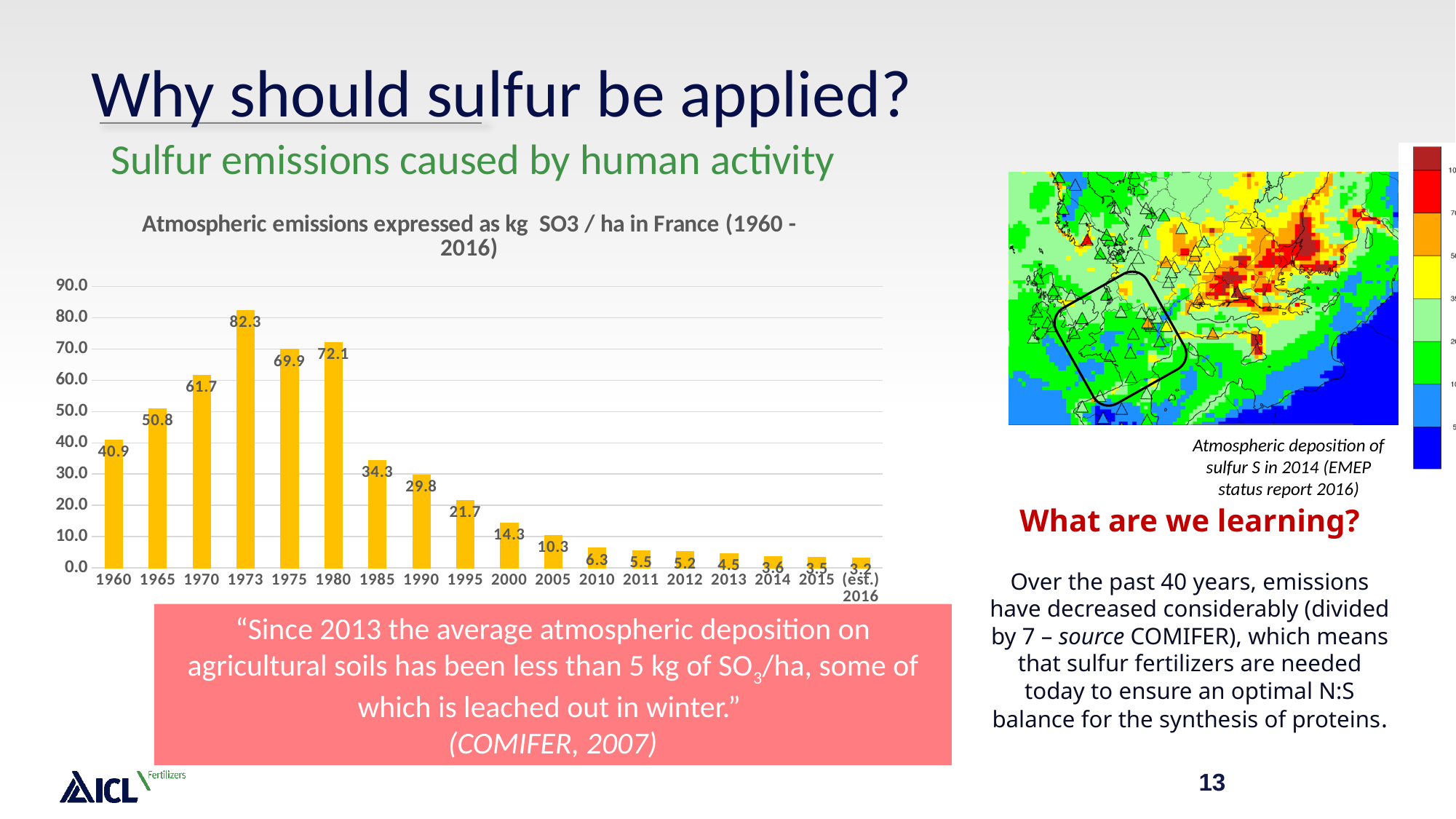
What is the value for 1973 in the chart? 82.3 What kind of chart is shown on the slide? bar chart What is the value for 1960 in the chart? 40.9 Which category has the lowest value in the chart? (est.) 2016 What is the value for 2000 in the chart? 14.3 Which year has the highest value in the chart? 1973 Is the value for 1970 greater or less than 60.0? greater What is the title of the chart? Atmospheric emissions expressed as kg SO3 / ha in France (1960 - 2016) How many categories (years) are shown on the x axis of the chart? 18 Do the values generally rise or fall from 1980 to 2016? fall Which is larger, the value for 1985 or the value for 1990? 1985 What is the difference between the values for 1980 and 1975? 2.2